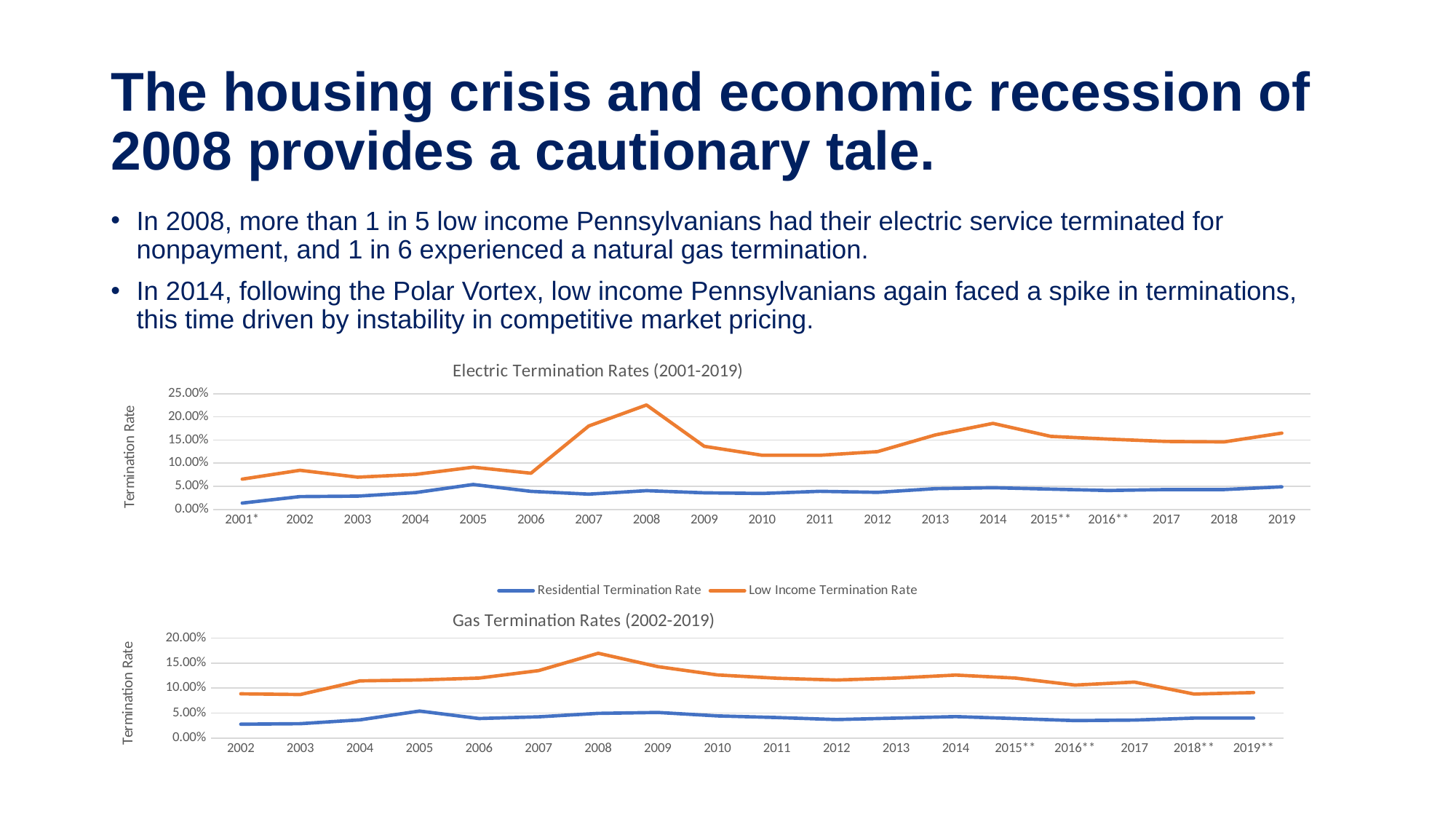
In the Electric Termination Rates (2001-2019) chart, does the Low Income Termination Rate rise or fall from 2006 to 2008? rise In the Gas Termination Rates (2002-2019) chart, is the Low Income Termination Rate for 2008 greater or less than 15.00%? greater In the Electric Termination Rates (2001-2019) chart, which year has the highest Low Income Termination Rate? 2008 In the Electric Termination Rates (2001-2019) chart, is the Low Income Termination Rate for 2006 greater or less than 10.00%? less How many years are plotted on the x axis of the Electric Termination Rates (2001-2019) chart? 19 Which colour is used for the Low Income Termination Rate line in the charts? orange How many years are plotted on the x axis of the Gas Termination Rates (2002-2019) chart? 18 What kind of chart is the Electric Termination Rates (2001-2019) chart? line chart In the Electric Termination Rates (2001-2019) chart, is the Low Income Termination Rate for 2008 greater or less than 20.00%? greater In the Gas Termination Rates (2002-2019) chart, which year has the highest Low Income Termination Rate? 2008 In the Electric Termination Rates (2001-2019) chart, which series has the larger value in 2008, Residential Termination Rate or Low Income Termination Rate? Low Income Termination Rate How many series does the legend list for the termination rate charts? 2